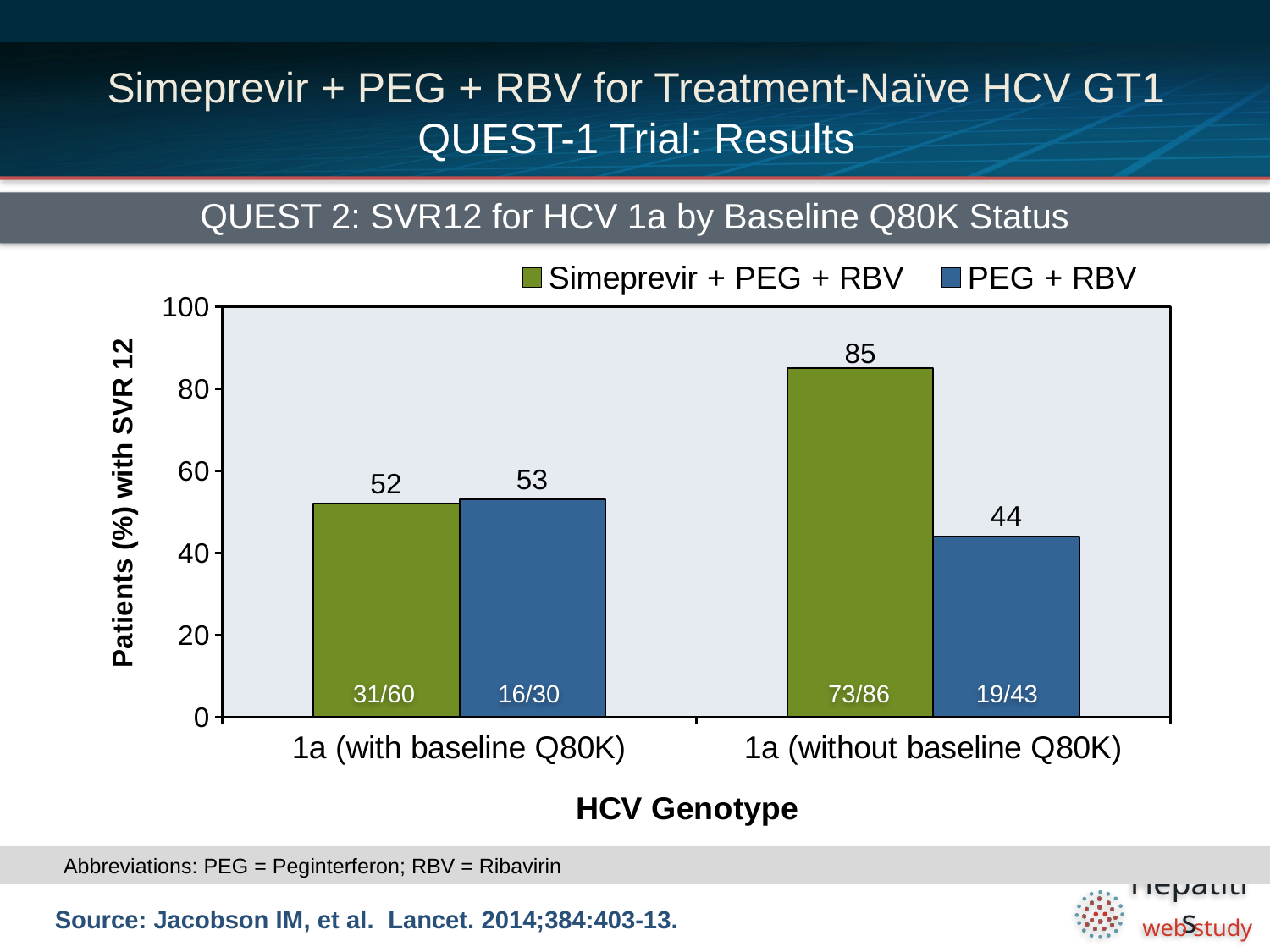
How many HCV genotype categories are shown on the x axis? 2 What is the SVR12 rate for Simeprevir + PEG + RBV in patients with HCV 1a with baseline Q80K? 52 What is the SVR12 rate for PEG + RBV in patients with HCV 1a with baseline Q80K? 53 Which bar shows the highest SVR12 rate on the chart? Simeprevir + PEG + RBV, 1a (without baseline Q80K) For patients without baseline Q80K, which treatment has the higher SVR12 rate? Simeprevir + PEG + RBV What kind of chart is shown on the slide? Bar chart Which bar shows the lowest SVR12 rate on the chart? PEG + RBV, 1a (without baseline Q80K) How many series does the legend list? 2 What is the SVR12 rate for Simeprevir + PEG + RBV in patients with HCV 1a without baseline Q80K? 85 What is the fraction label shown inside the Simeprevir + PEG + RBV bar for patients without baseline Q80K? 73/86 What is the difference in SVR12 rate between Simeprevir + PEG + RBV and PEG + RBV in patients without baseline Q80K? 41 What is the SVR12 rate for PEG + RBV in patients with HCV 1a without baseline Q80K? 44